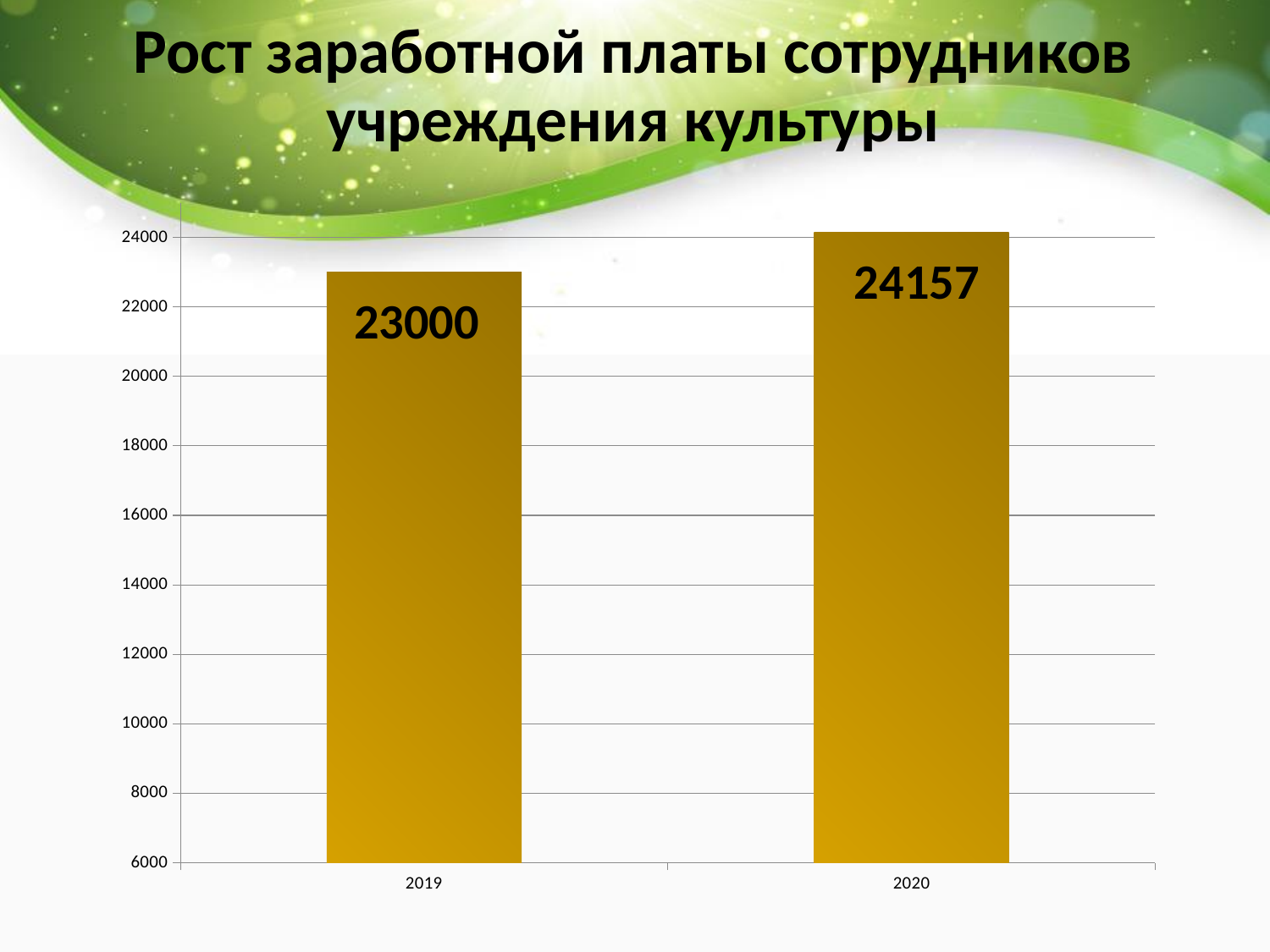
Do the values rise or fall from 2019 to 2020? rise What kind of chart is shown on the slide? bar chart Is the value for 2020 greater or less than 24000? greater What is the title of the slide? Рост заработной платы сотрудников учреждения культуры What is the difference between the values for 2020 and 2019? 1157 What is the value for 2020? 24157 Is the value for 2019 greater or less than 22000? greater Which is larger, the value for 2019 or the value for 2020? 2020 Which year has the lowest value? 2019 Which year has the highest value? 2020 How many categories are shown on the x axis? 2 What is the value for 2019? 23000